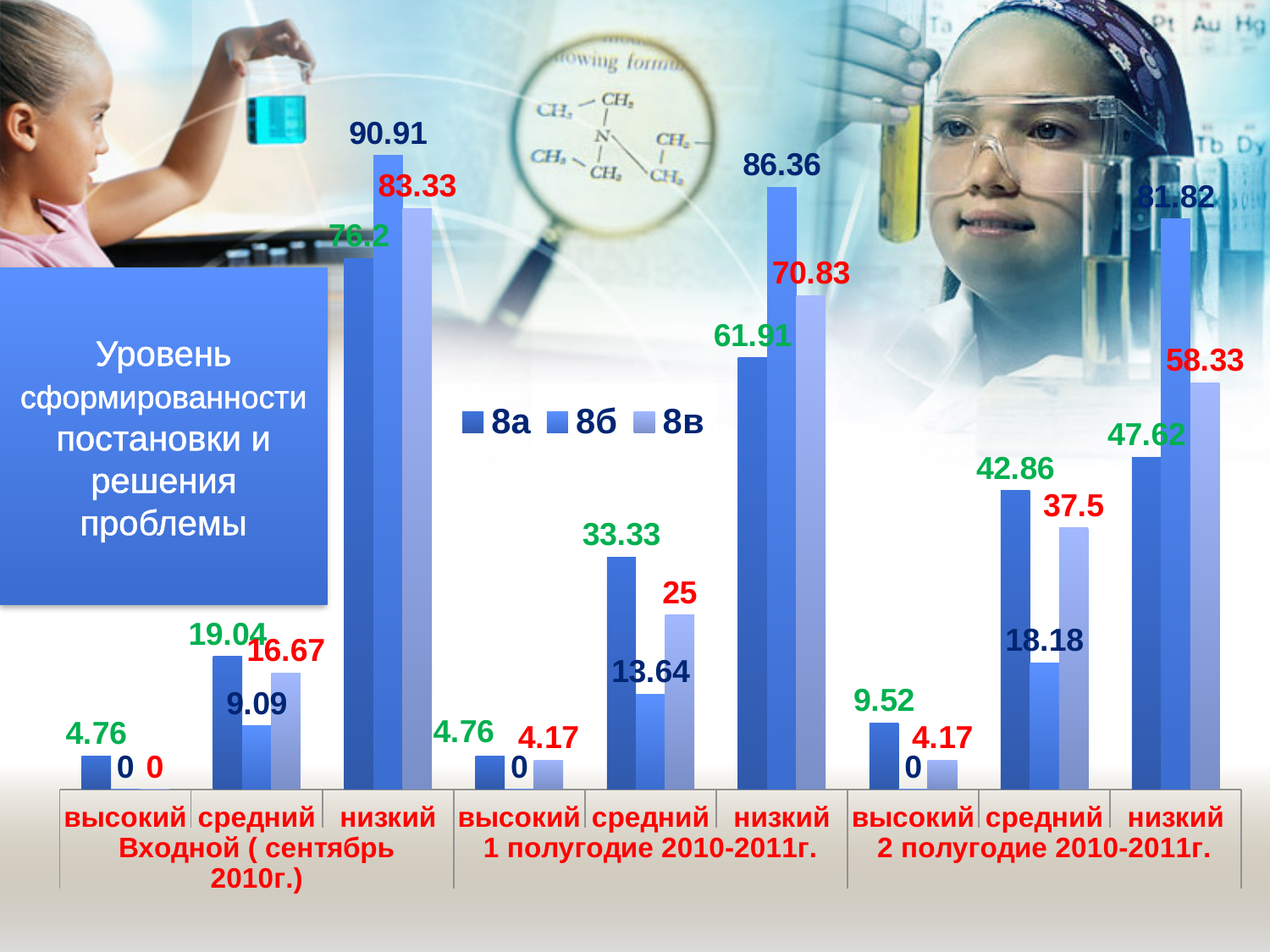
Which series has the lowest value in the средний category of 2 полугодие 2010-2011г.? 8б What is the value for 8б in the низкий category of Входной (сентябрь 2010г.)? 90.91 What is the value for 8а in the средний category of 1 полугодие 2010-2011г.? 33.33 What is the value for 8б in the высокий category of 2 полугодие 2010-2011г.? 0 Which is larger: the 8а value or the 8в value in the средний category of 1 полугодие 2010-2011г.? 8а Which series has the highest value in the низкий category of 1 полугодие 2010-2011г.? 8б What type of chart is shown on the slide? bar chart What is the title of the chart? Уровень сформированности постановки и решения проблемы How does the 8а value in the низкий category change from Входной (сентябрь 2010г.) to 2 полугодие 2010-2011г.? falls What is the value for 8в in the низкий category of 2 полугодие 2010-2011г.? 58.33 How many series does the legend list? 3 What is the difference between the 8а and 8б values in the средний category of Входной (сентябрь 2010г.)? 9.95